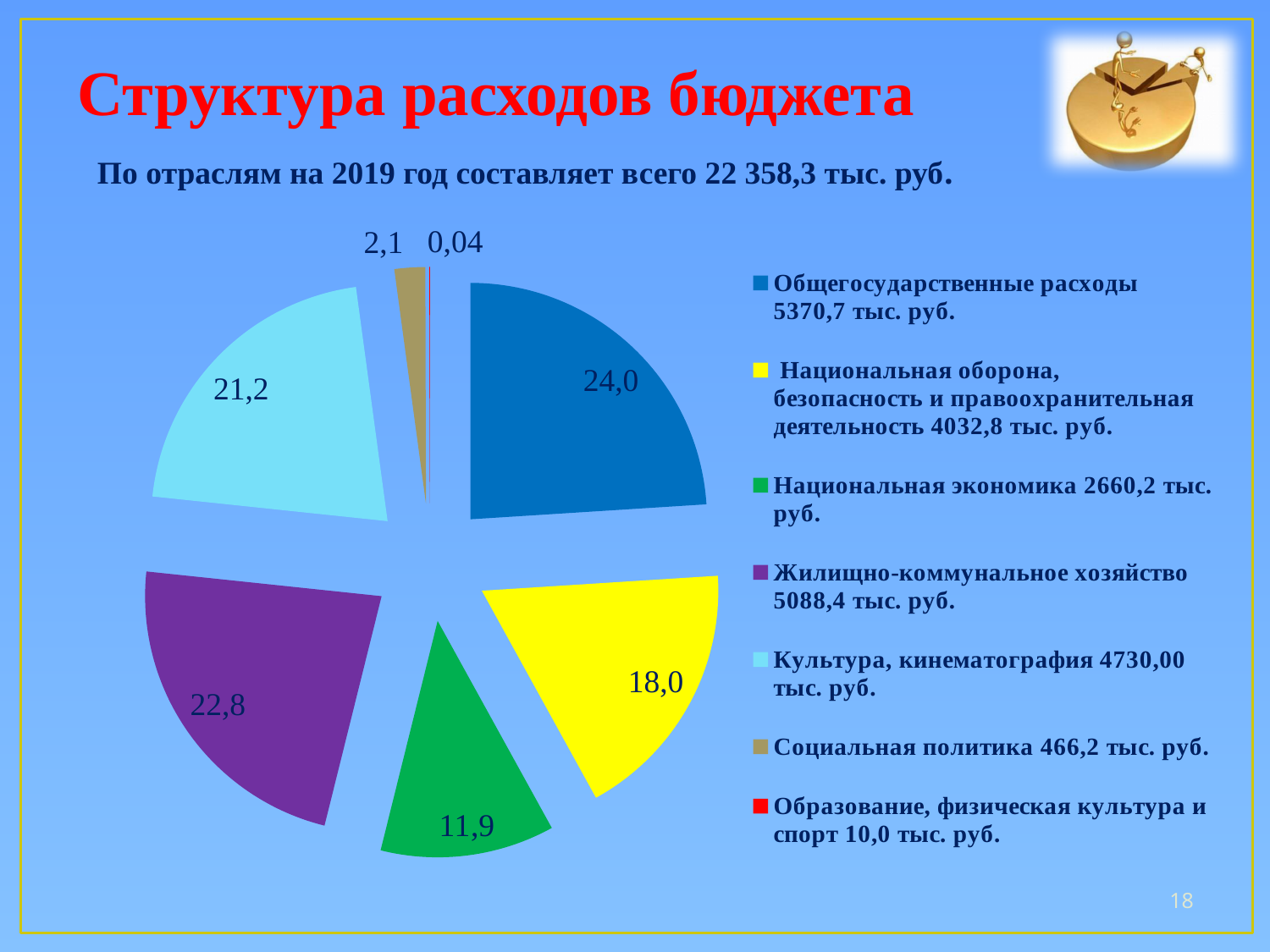
Which category has the smallest slice of the pie? Образование, физическая культура и спорт Which category has the largest slice of the pie? Общегосударственные расходы What is the data label on the slice for Жилищно-коммунальное хозяйство? 22,8 What is the difference between the data labels for Общегосударственные расходы and Жилищно-коммунальное хозяйство? 1,2 How many categories does the legend list? 7 What is the data label on the slice for Национальная экономика? 11,9 What is the data label on the slice for Социальная политика? 2,1 What is the data label on the slice for Общегосударственные расходы? 24,0 Which slice is larger: Культура, кинематография or Национальная оборона, безопасность и правоохранительная деятельность? Культура, кинематография What is the title of the slide containing the chart? Структура расходов бюджета What is the difference between the data labels for Национальная оборона, безопасность и правоохранительная деятельность and Национальная экономика? 6,1 What kind of chart is shown on the slide? Pie chart